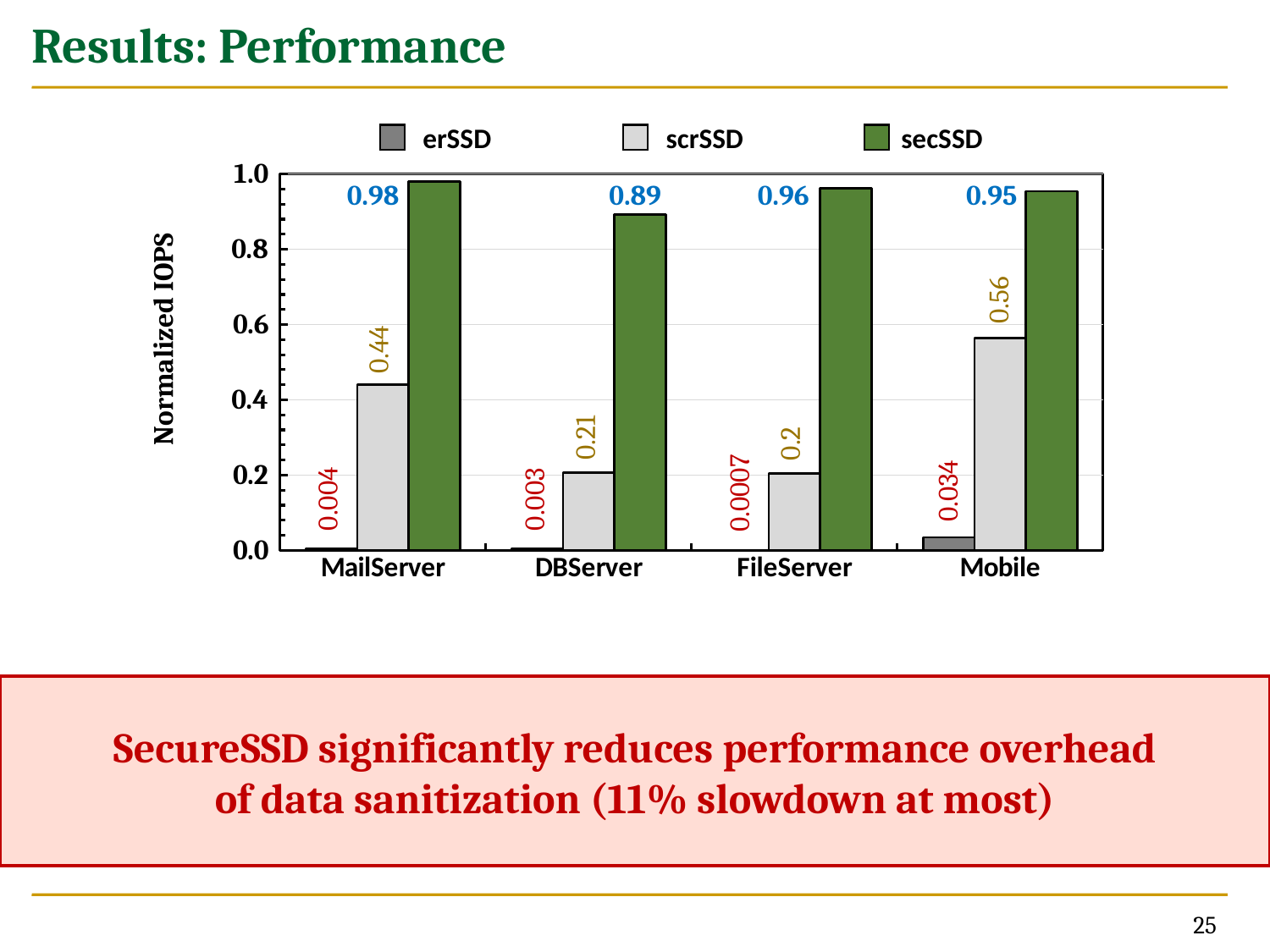
How many series does the legend list? 3 How many workload categories are shown on the x axis? 4 What is the normalized IOPS of erSSD for FileServer? 0.0007 What is the normalized IOPS of secSSD for MailServer? 0.98 What is the normalized IOPS of scrSSD for Mobile? 0.56 Which is larger for Mobile: the erSSD value or the scrSSD value? scrSSD What is the difference between the secSSD and scrSSD normalized IOPS for MailServer? 0.54 Is the secSSD value for DBServer greater or less than 0.8? greater For which workload does secSSD have the lowest normalized IOPS? DBServer For which workload does scrSSD have the highest normalized IOPS? Mobile What kind of chart is shown on the slide? Bar chart What is the normalized IOPS of scrSSD for DBServer? 0.21